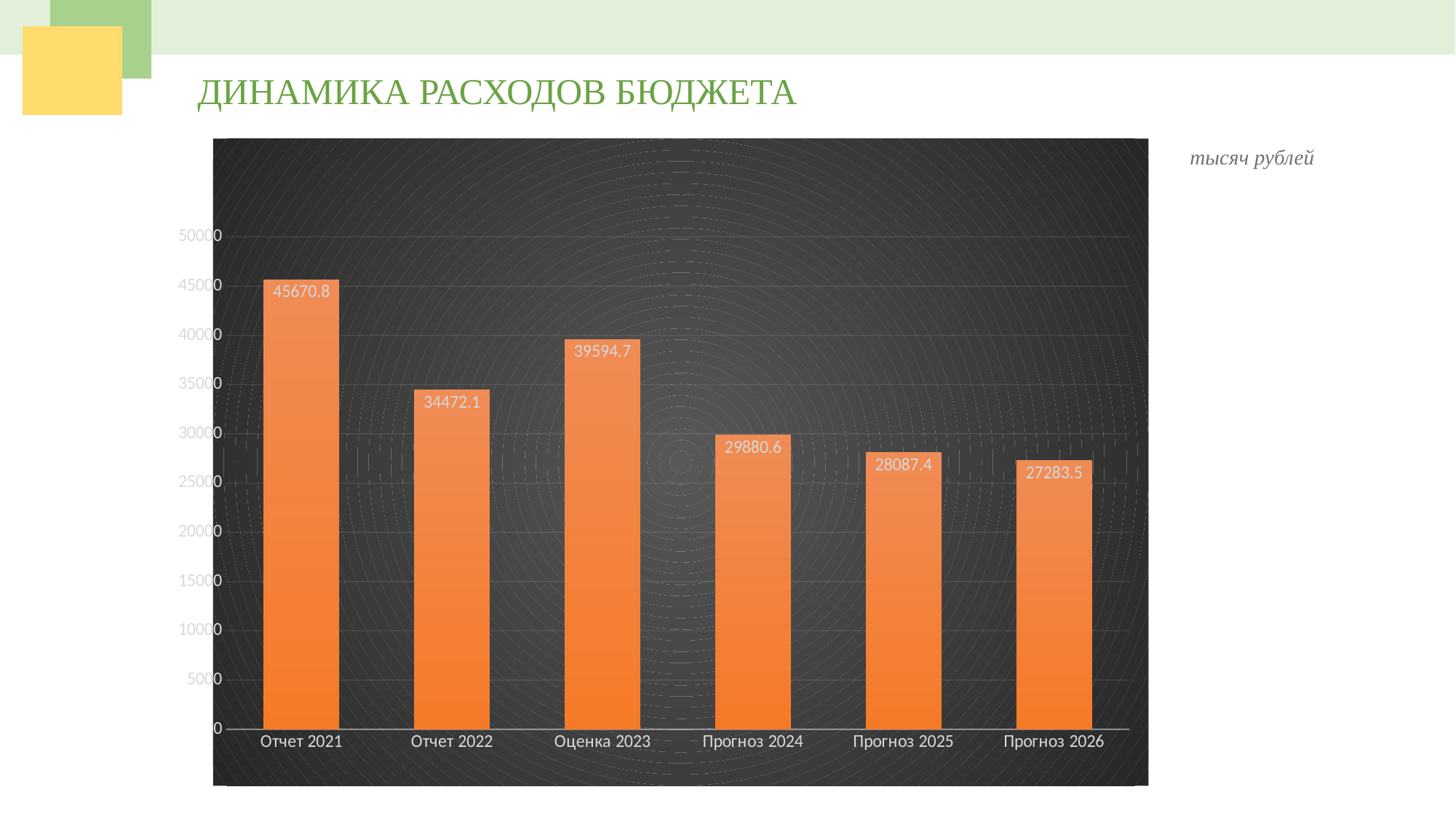
What is the difference between the values for Отчет 2021 and Отчет 2022? 11198.7 How many categories are shown on the x axis? 6 Which category has the highest value? Отчет 2021 What kind of chart is shown on the slide? bar chart What is the title of the slide above the chart? ДИНАМИКА РАСХОДОВ БЮДЖЕТА What is the value for Прогноз 2024? 29880.6 What is the value for Оценка 2023? 39594.7 What is the difference between the values for Оценка 2023 and Прогноз 2024? 9714.1 Which category has the lowest value? Прогноз 2026 Which is larger, the value for Отчет 2022 or the value for Оценка 2023? Оценка 2023 What is the value for Отчет 2021? 45670.8 Is the value for Прогноз 2025 greater or less than 30000? less